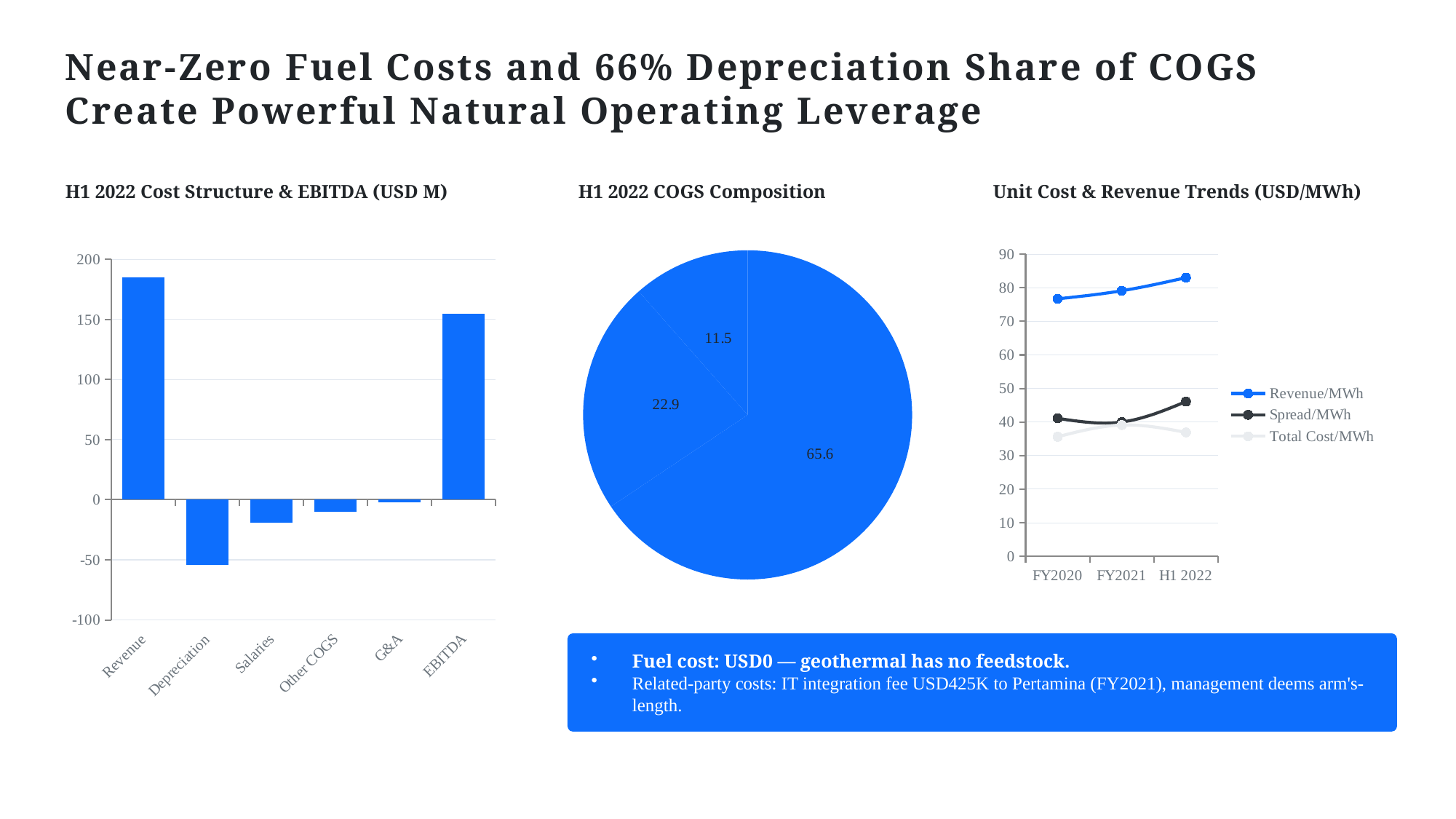
What kind of chart is the 'H1 2022 Cost Structure & EBITDA (USD M)' chart? bar chart In the 'H1 2022 Cost Structure & EBITDA (USD M)' chart, is the value for EBITDA greater or less than 100? greater In the 'H1 2022 Cost Structure & EBITDA (USD M)' chart, is the value for Depreciation greater or less than -50? less How many categories are shown on the x axis of the 'H1 2022 Cost Structure & EBITDA (USD M)' chart? 6 In the 'H1 2022 COGS Composition' pie chart, what is the value of the largest slice? 65.6 In the 'H1 2022 Cost Structure & EBITDA (USD M)' chart, which is larger, Revenue or EBITDA? Revenue What kind of chart is the 'H1 2022 COGS Composition' chart? pie chart In the 'Unit Cost & Revenue Trends (USD/MWh)' chart, is the Revenue/MWh value for H1 2022 greater or less than 80? greater How many series does the legend of the 'Unit Cost & Revenue Trends (USD/MWh)' chart list? 3 In the 'H1 2022 Cost Structure & EBITDA (USD M)' chart, which category has the lowest value? Depreciation In the 'H1 2022 Cost Structure & EBITDA (USD M)' chart, which category has the highest value? Revenue In the 'Unit Cost & Revenue Trends (USD/MWh)' chart, does Revenue/MWh rise or fall from FY2020 to H1 2022? rise